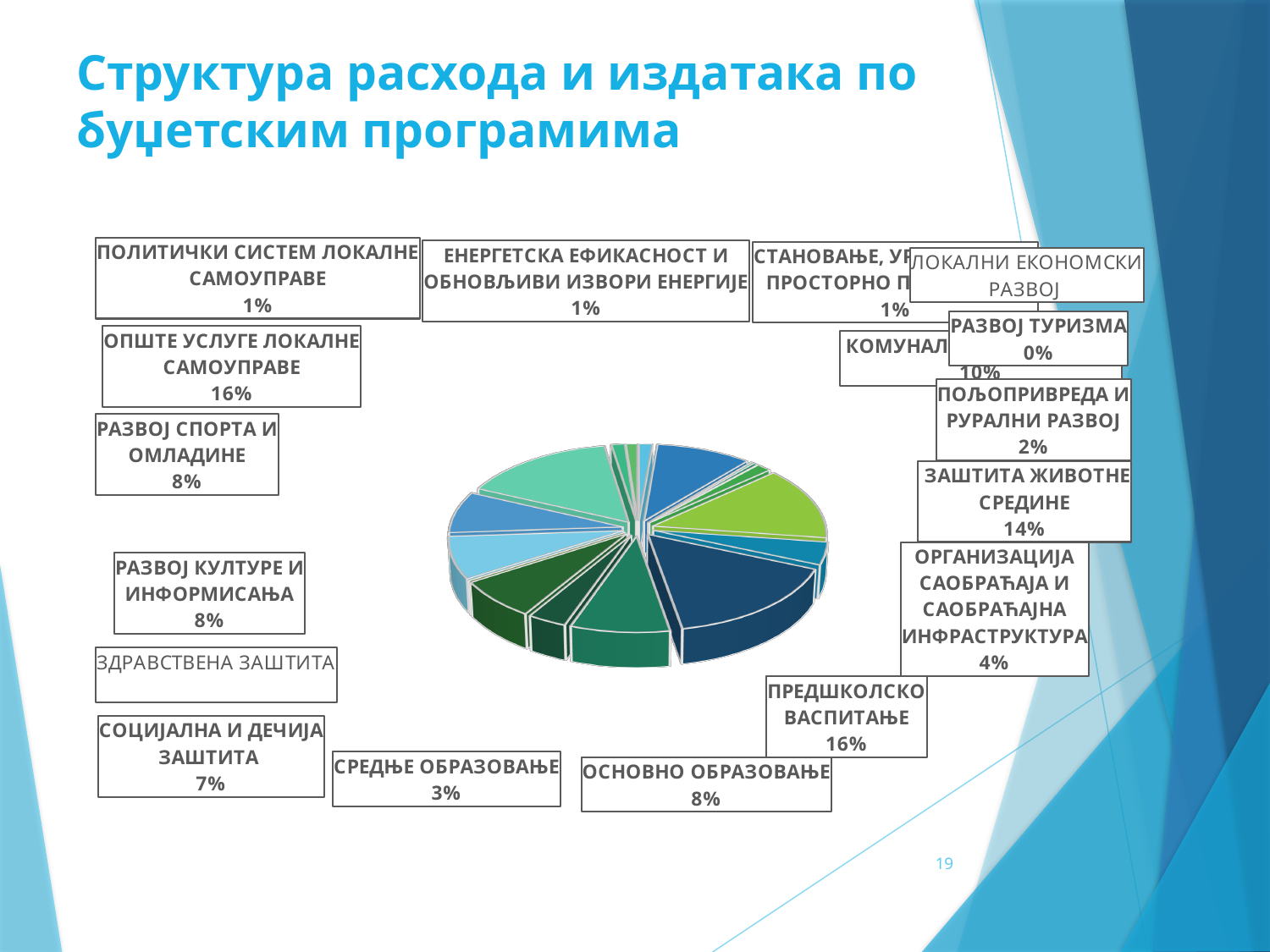
What share does ЗАШТИТА ЖИВОТНЕ СРЕДИНЕ have in the pie chart? 14% Which has the larger share: РАЗВОЈ СПОРТА И ОМЛАДИНЕ or ПОЉОПРИВРЕДА И РУРАЛНИ РАЗВОЈ? РАЗВОЈ СПОРТА И ОМЛАДИНЕ What share does СОЦИЈАЛНА И ДЕЧИЈА ЗАШТИТА have in the pie chart? 7% What is the difference in share between ЗАШТИТА ЖИВОТНЕ СРЕДИНЕ and ОСНОВНО ОБРАЗОВАЊЕ? 6% What share does ОПШТЕ УСЛУГЕ ЛОКАЛНЕ САМОУПРАВЕ have in the pie chart? 16% What is the title of the slide containing the chart? Структура расхода и издатака по буџетским програмима What kind of chart is shown on the slide? pie chart What share does ПРЕДШКОЛСКО ВАСПИТАЊЕ have in the pie chart? 16% What share does СРЕДЊЕ ОБРАЗОВАЊЕ have in the pie chart? 3% What is the difference in share between ПРЕДШКОЛСКО ВАСПИТАЊЕ and СРЕДЊЕ ОБРАЗОВАЊЕ? 13% What share does ОРГАНИЗАЦИЈА САОБРАЋАЈА И САОБРАЋАЈНА ИНФРАСТРУКТУРА have in the pie chart? 4%